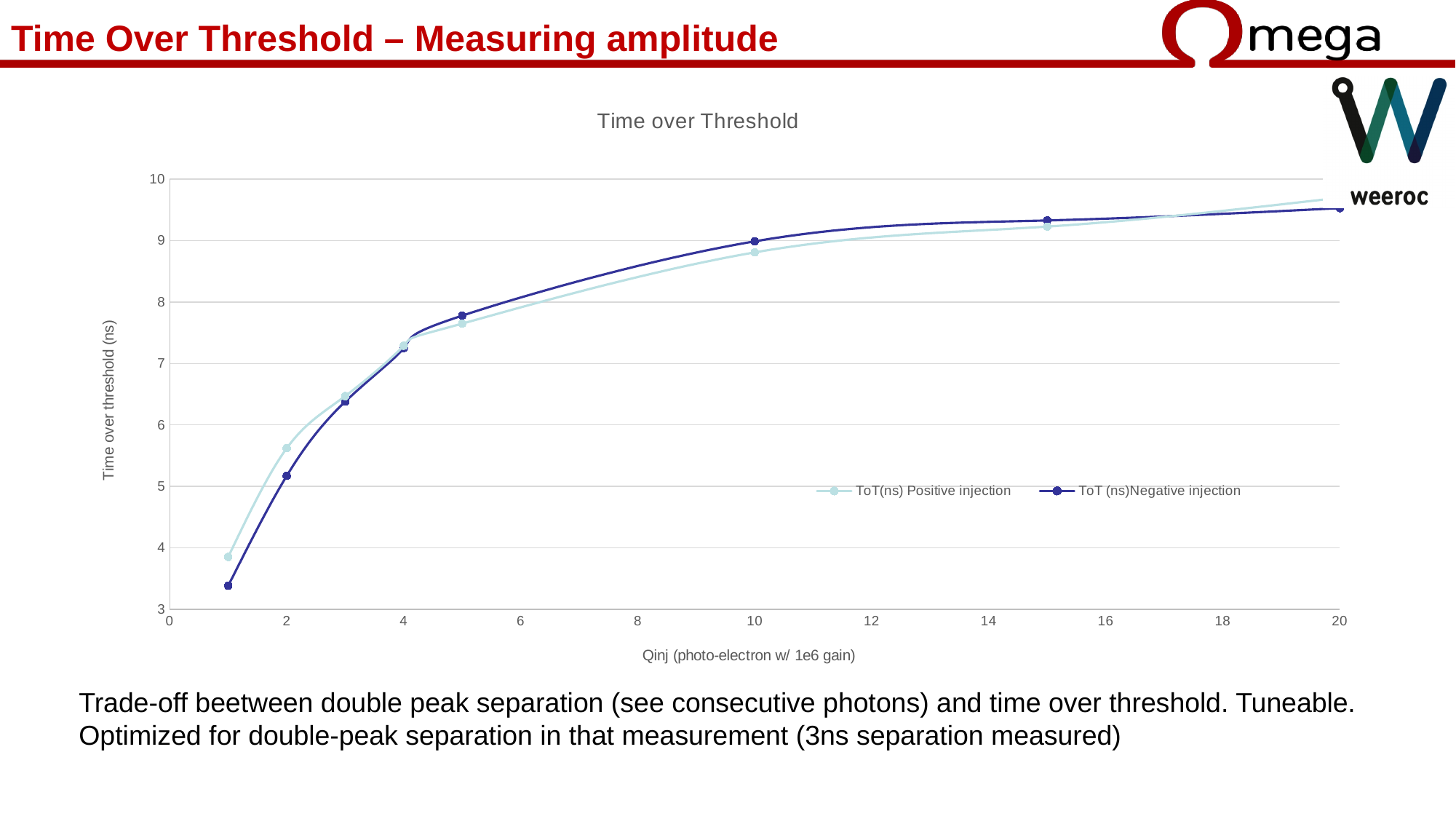
What is the title of the chart? Time over Threshold Is the ToT (ns)Negative injection value at Qinj = 1 greater or less than 4? less Is the ToT (ns)Negative injection value at Qinj = 5 greater or less than 8? less At Qinj = 10, which series has the larger time over threshold, Positive injection or Negative injection? Negative injection Do the time over threshold values rise or fall as Qinj increases? rise At Qinj = 2, which series has the larger time over threshold, Positive injection or Negative injection? Positive injection How many series does the legend list? 2 Is the ToT(ns) Positive injection value at Qinj = 2 greater or less than 5? greater What is the label of the x axis? Qinj (photo-electron w/ 1e6 gain) How many data points are plotted for the ToT(ns) Positive injection series? 8 What kind of chart is shown on the slide? line chart